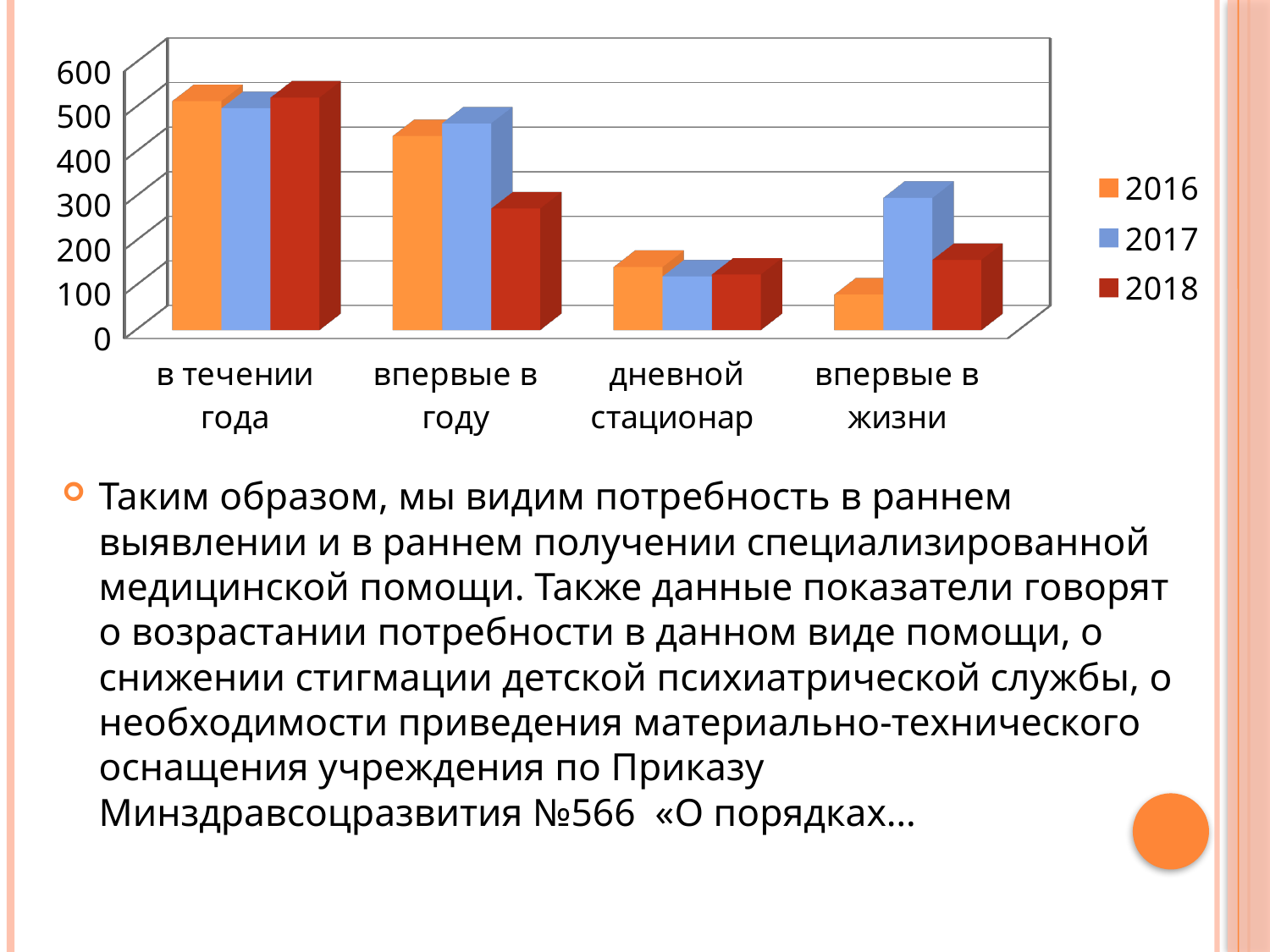
How many series does the chart's legend list? 3 Is the value for 2016 in the category 'в течении года' greater or less than 400? greater In the category 'впервые в жизни', which year has the highest bar? 2017 Is the value for 2018 in the category 'впервые в году' greater or less than 400? less Which years are listed in the chart's legend? 2016, 2017, 2018 How many categories are shown on the x axis of the chart? 4 Which is larger: the 2016 value for 'дневной стационар' or the 2016 value for 'впервые в жизни'? дневной стационар Is the value for 2016 in the category 'впервые в жизни' greater or less than 200? less What kind of chart is shown on the slide? bar chart What colour are the bars for the 2017 series? blue In the category 'впервые в году', which year has the lowest bar? 2018